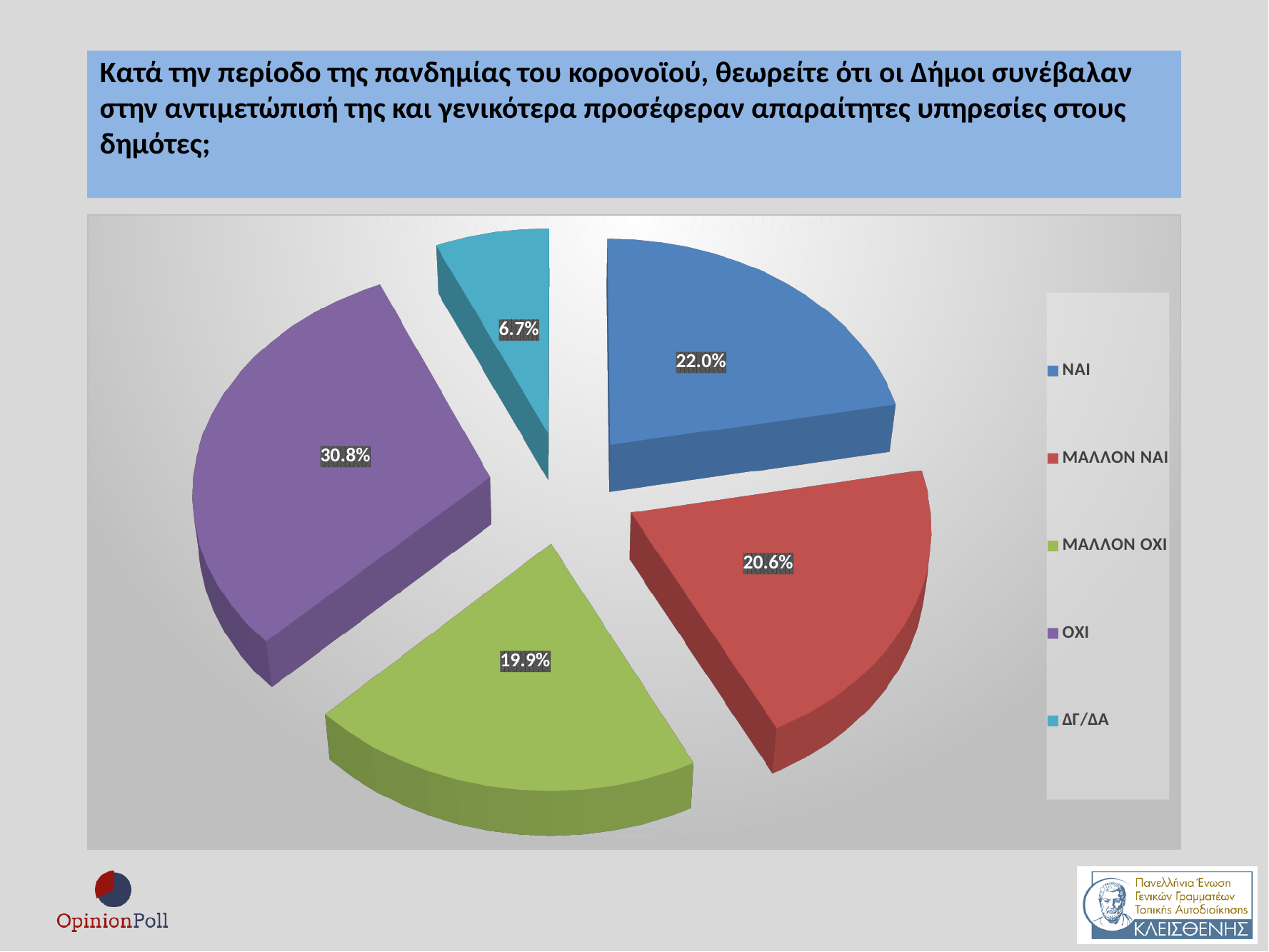
How many slices does the pie chart have? 5 Which category has the largest slice of the pie? ΟΧΙ What share of the pie does ΔΓ/ΔΑ have? 6.7% Which category has the smallest slice of the pie? ΔΓ/ΔΑ What is the difference in percentage points between ΟΧΙ and ΝΑΙ? 8.8 What kind of chart is shown on the slide? Pie chart Which is larger, the slice for ΝΑΙ or the slice for ΔΓ/ΔΑ? ΝΑΙ What share of the pie does ΝΑΙ have? 22.0% What colour is the slice for ΜΑΛΛΟΝ ΟΧΙ? Green What share of the pie does ΜΑΛΛΟΝ ΝΑΙ have? 20.6% What share of the pie does ΟΧΙ have? 30.8% What share of the pie does ΜΑΛΛΟΝ ΟΧΙ have? 19.9%